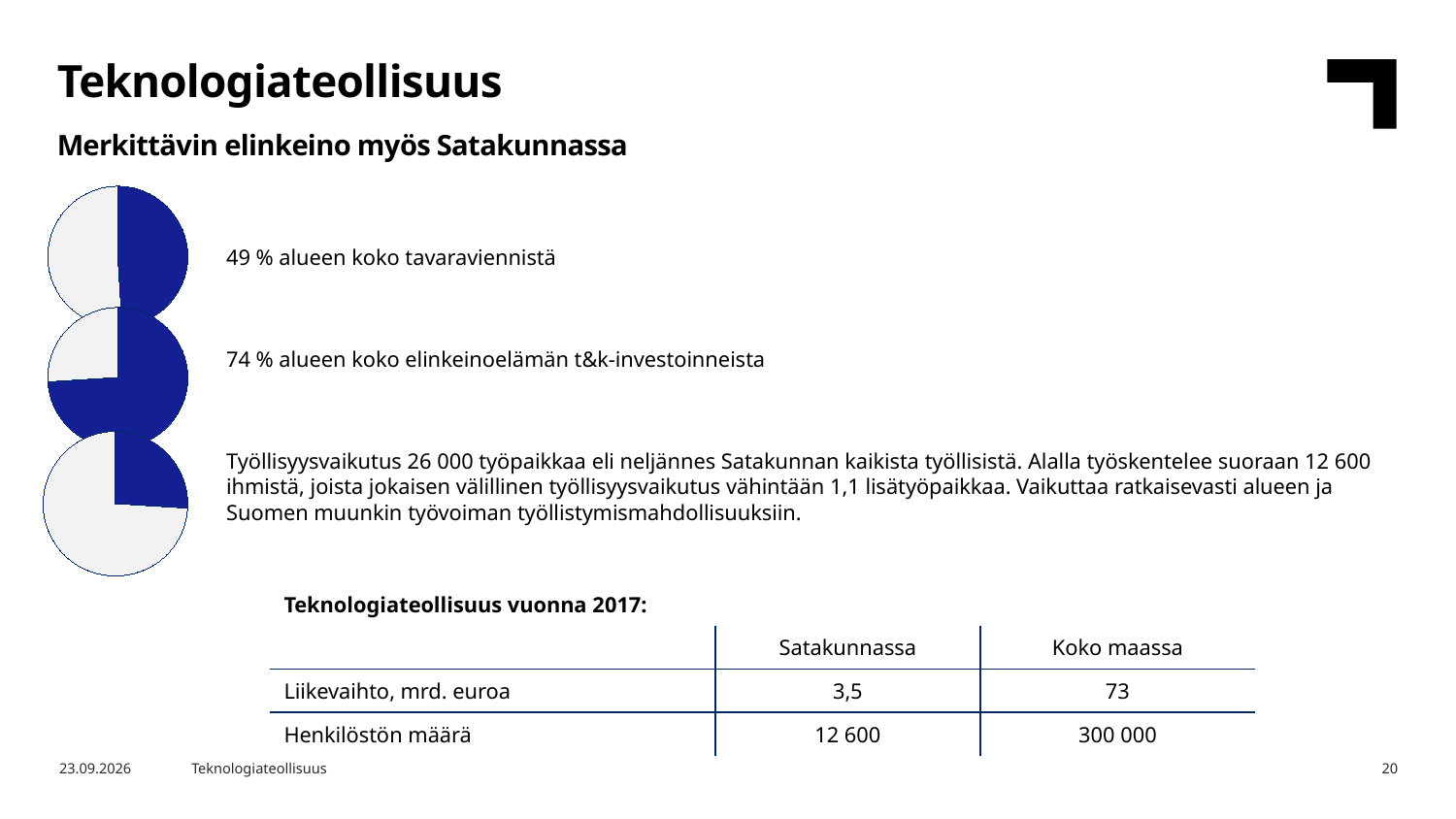
What colour is the highlighted slice in each pie chart? Blue How many pie charts are on the slide? 3 What does the top pie chart illustrate according to the text next to it? 49 % alueen koko tavaraviennistä In the middle pie chart, what share of the region's business R&D investments (elinkeinoelämän t&k-investoinnit) does the blue slice represent? 74 % What kind of charts are shown on the left side of the slide? Pie charts Which pie chart has the larger blue slice, the top one or the middle one? The middle one Which of the three pie charts has the largest blue slice? The middle one (74 %) What is the difference in percentage points between the blue shares of the middle and top pie charts? 25 percentage points Which of the three pie charts has the smallest blue slice? The bottom one In the middle pie chart, is the blue slice greater or less than 50 % of the pie? greater In the top pie chart, what share of the region's total goods exports (alueen koko tavaravienti) does the blue slice represent? 49 % In the bottom pie chart, is the blue slice greater or less than 50 % of the pie? less